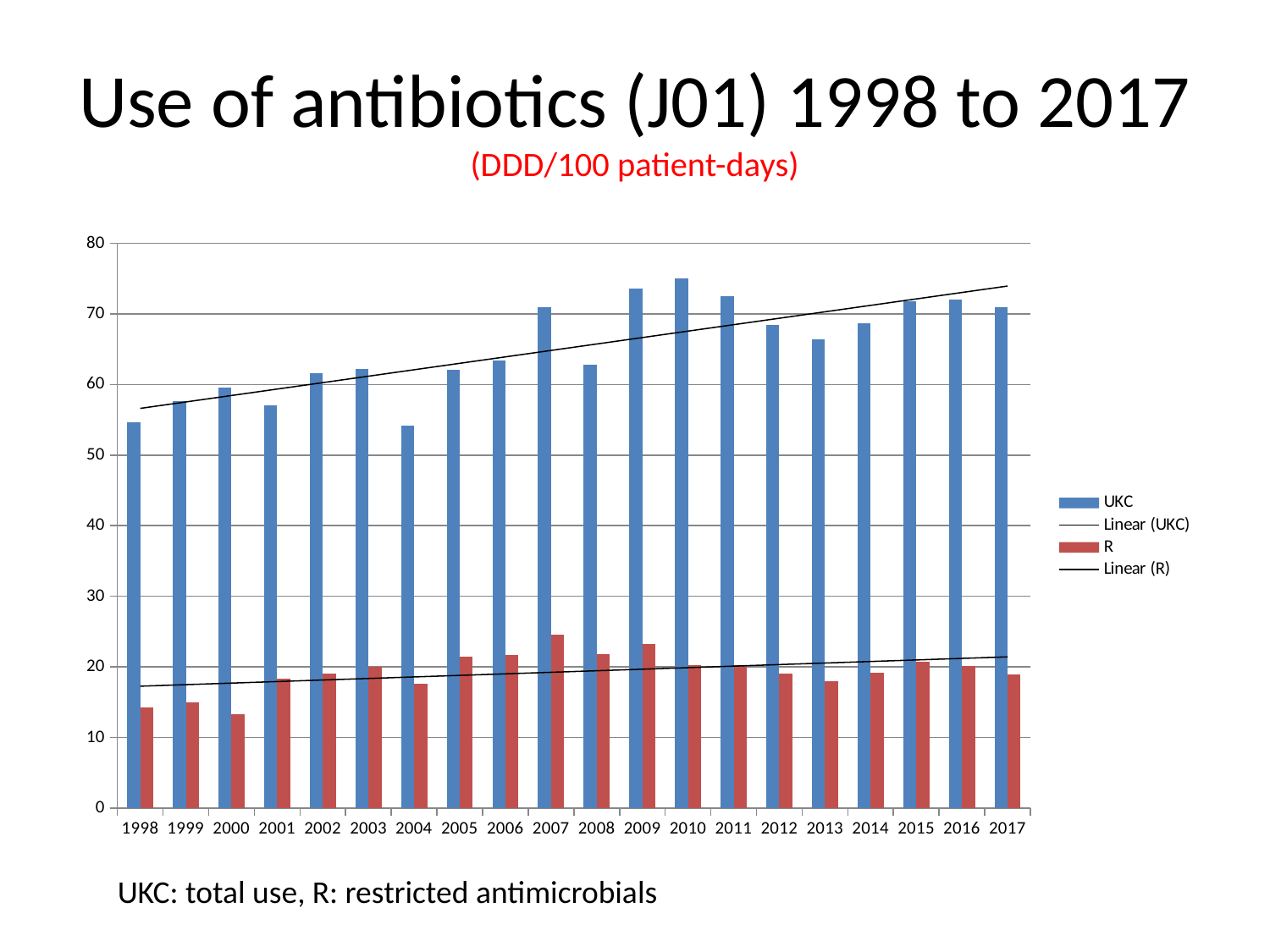
How many years are shown on the x axis of the chart? 20 How many entries does the chart legend list? 4 Is the UKC value for 2010 greater or less than 70? greater What kind of chart is shown on the slide? Bar chart In which year is the R value highest? 2007 Is the R value for 2007 greater or less than 20? greater In which year is the UKC value highest? 2010 Is the R value for 2000 greater or less than 20? less Which year has the larger UKC value, 2004 or 2005? 2005 Does the Linear (UKC) trend line rise or fall from 1998 to 2017? Rise In what units are the values on the chart expressed, according to the subtitle? DDD/100 patient-days